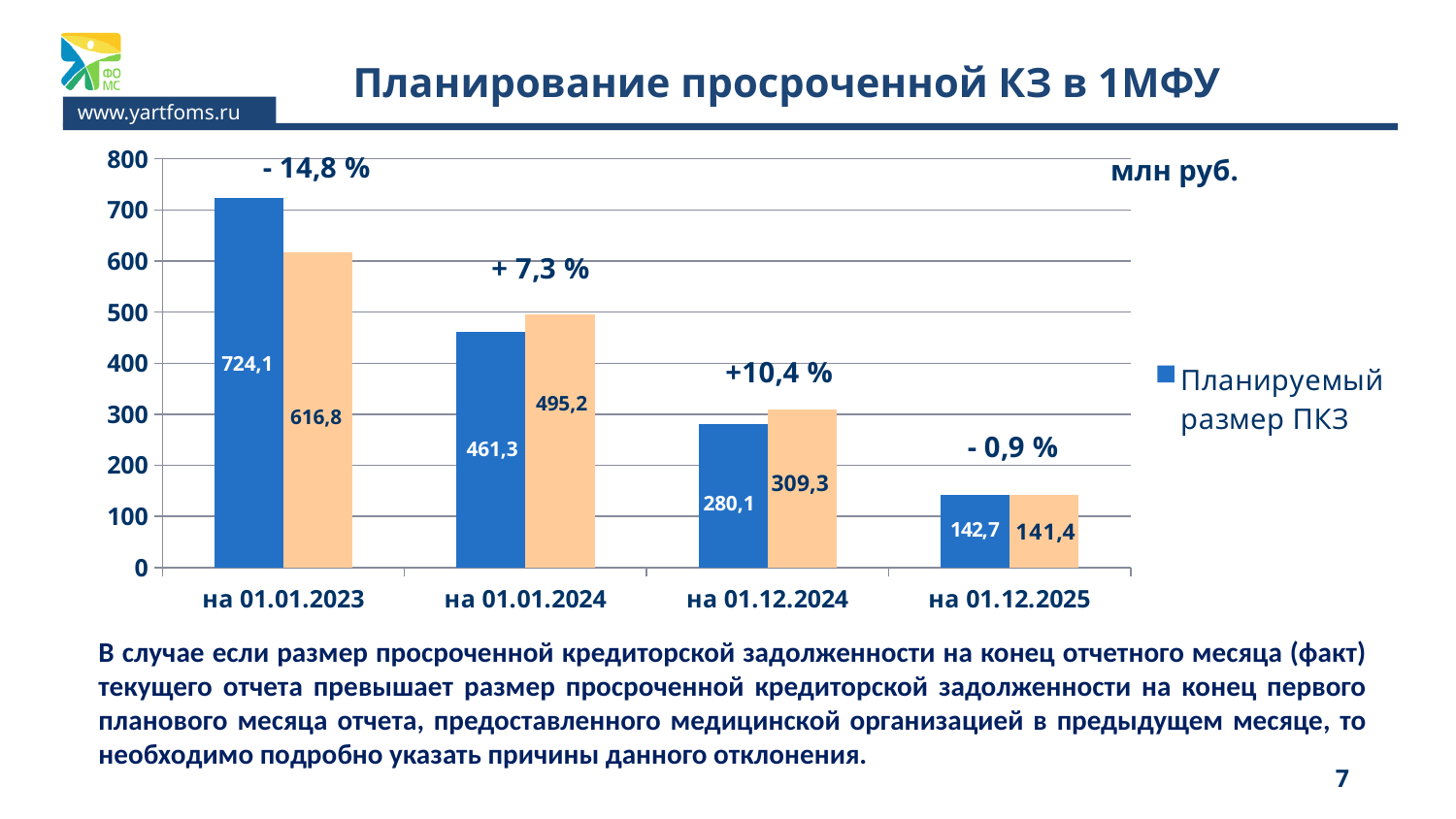
Which category has the highest value for Планируемый размер ПКЗ (blue bars)? на 01.01.2023 What percentage label is shown above the bars for на 01.12.2024? +10,4 % For на 01.01.2024, which is larger: the blue bar or the orange bar? the orange bar What is the difference between the blue bar and the orange bar for на 01.01.2023? 107,3 What type of chart is shown on the slide? bar chart How many categories are shown on the x axis? 4 What is the value of the orange bar for на 01.12.2025? 141,4 Which category has the lowest value for the orange bars? на 01.12.2025 What is the value of the orange bar for на 01.01.2024? 495,2 What is the value of the blue bar (Планируемый размер ПКЗ) for на 01.01.2023? 724,1 What is the value of the blue bar (Планируемый размер ПКЗ) for на 01.12.2024? 280,1 Do the values of Планируемый размер ПКЗ (blue bars) rise or fall from left to right along the x axis? fall